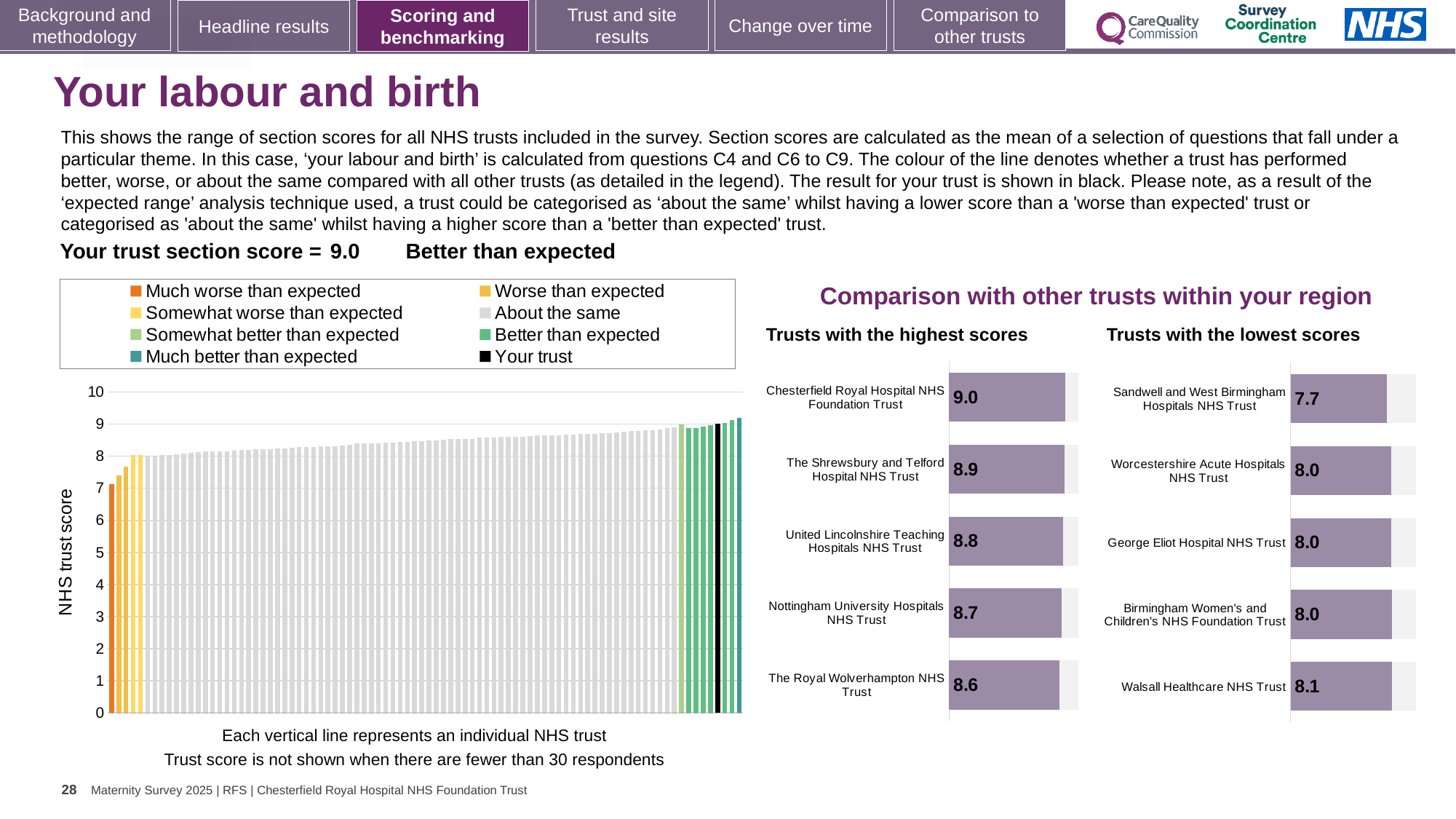
In the 'Trusts with the lowest scores' chart, which is larger: the score for Walsall Healthcare NHS Trust or Sandwell and West Birmingham Hospitals NHS Trust? Walsall Healthcare NHS Trust In the 'Trusts with the highest scores' chart, what is the score for Chesterfield Royal Hospital NHS Foundation Trust? 9.0 In the 'Trusts with the highest scores' chart, what is the score for The Royal Wolverhampton NHS Trust? 8.6 In the 'Trusts with the lowest scores' chart, which trust has the lowest score? Sandwell and West Birmingham Hospitals NHS Trust In the main 'NHS trust score' chart, is the value of the leftmost (orange) bar greater or less than 8? less In the 'Trusts with the lowest scores' chart, what is the score for Walsall Healthcare NHS Trust? 8.1 In the main 'NHS trust score' chart, do the bar values rise or fall from left to right? Rise What kind of chart is the main 'NHS trust score' chart on the left? Bar chart In the 'Trusts with the highest scores' chart, what is the difference between the scores of Chesterfield Royal Hospital NHS Foundation Trust and Nottingham University Hospitals NHS Trust? 0.3 In the main 'NHS trust score' chart, what colour represents 'Your trust' in the legend? Black How many entries does the legend of the main 'NHS trust score' chart list? 8 How many trusts are shown in the 'Trusts with the highest scores' chart? 5